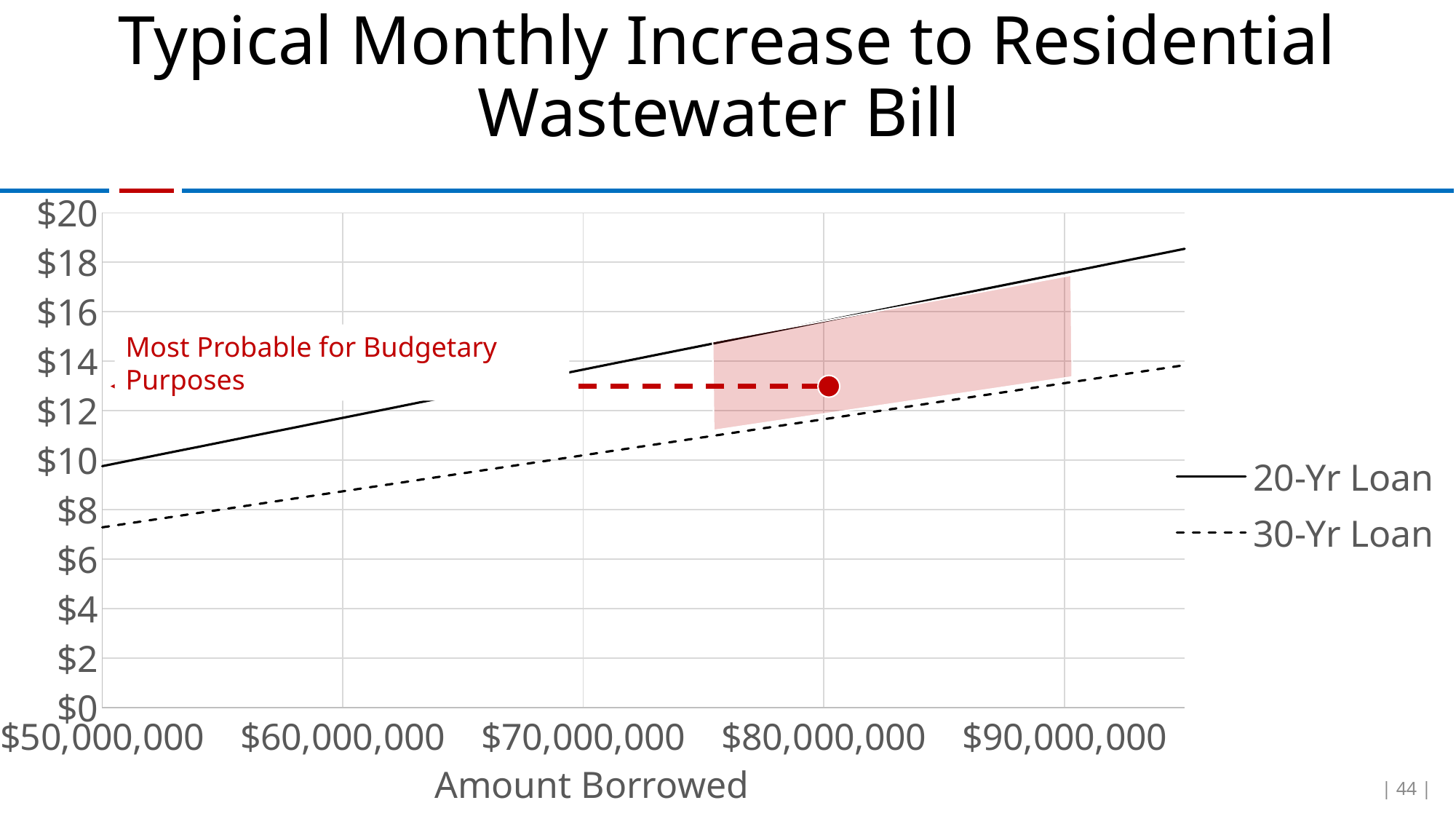
Do the values for the 30-Yr Loan rise or fall as the amount borrowed increases? Rise Is the value for the 30-Yr Loan at $50,000,000 greater or less than $8? less At an amount borrowed of $80,000,000, which series has the higher monthly increase, the 20-Yr Loan or the 30-Yr Loan? 20-Yr Loan Is the value for the 20-Yr Loan at $90,000,000 greater or less than $16? greater What is the title of the x axis? Amount Borrowed What kind of chart is shown on the slide? Line chart Is the value for the 30-Yr Loan at $90,000,000 greater or less than $12? greater What are the two series named in the legend? 20-Yr Loan and 30-Yr Loan How many series does the legend list? 2 Do the values for the 20-Yr Loan rise or fall as the amount borrowed increases? Rise